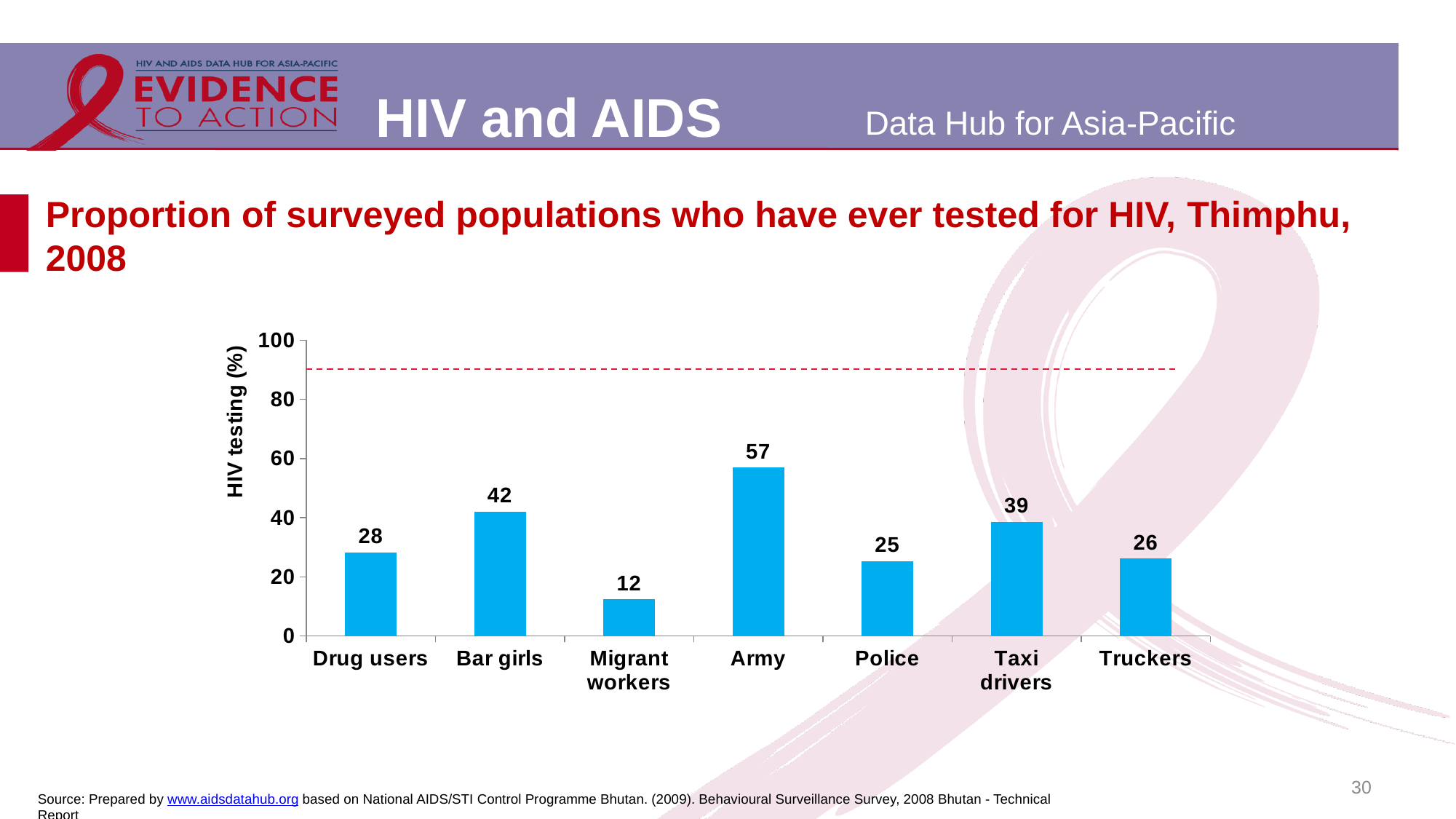
What is the HIV testing value for Migrant workers? 12 Which surveyed population has the lowest proportion ever tested for HIV? Migrant workers Which has a higher value, Bar girls or Taxi drivers? Bar girls What is the difference between the values for Army and Bar girls? 15 What kind of chart is shown on the slide? Bar chart What is the label of the vertical axis? HIV testing (%) How many surveyed populations are shown on the chart? 7 What is the difference between the values for Drug users and Migrant workers? 16 Is the value for Police greater or less than 40? less What is the HIV testing value for Army? 57 Which surveyed population has the highest proportion ever tested for HIV? Army What is the HIV testing value for Taxi drivers? 39